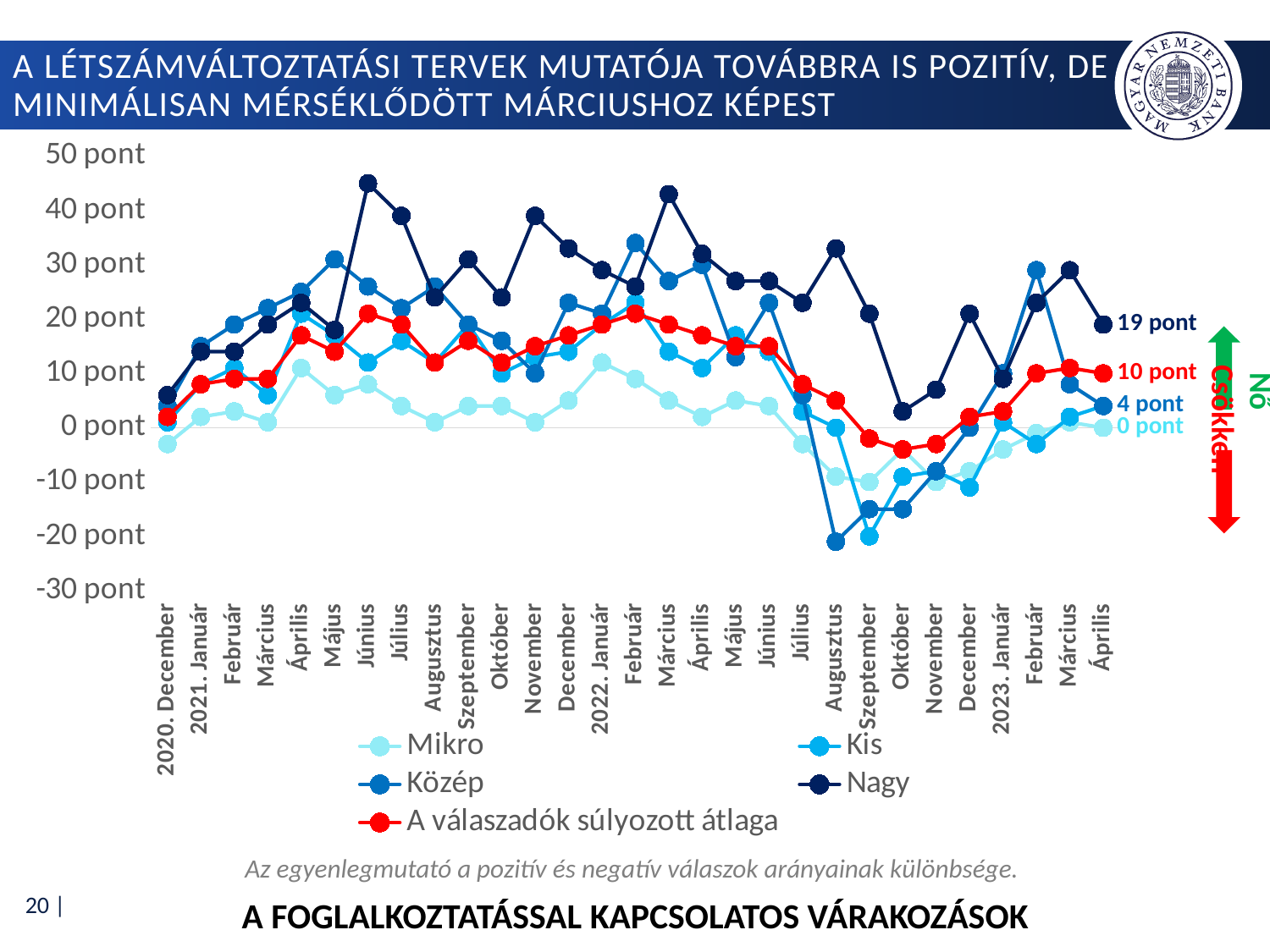
Is the value for Közép at 2022 Augusztus greater or less than -10 pont? less Which series has the highest value at 2023 Április? Nagy Is the value for Nagy at 2021 Június greater or less than 40 pont? greater At 2023 Április, what is the difference between the Nagy value and the weighted average (A válaszadók súlyozott átlaga)? 9 pont What is the value of the Mikro series at 2023 Április? 0 pont What is the value of the Nagy series at 2023 Április? 19 pont What is the value of 'A válaszadók súlyozott átlaga' at 2023 Április? 10 pont What kind of chart is shown on the slide? line chart How many series does the legend list? 5 What is the value of the Közép series at 2023 Április? 4 pont Which legend entry corresponds to the red line? A válaszadók súlyozott átlaga At 2023 Április, which is larger: the Nagy value or the Közép value? Nagy